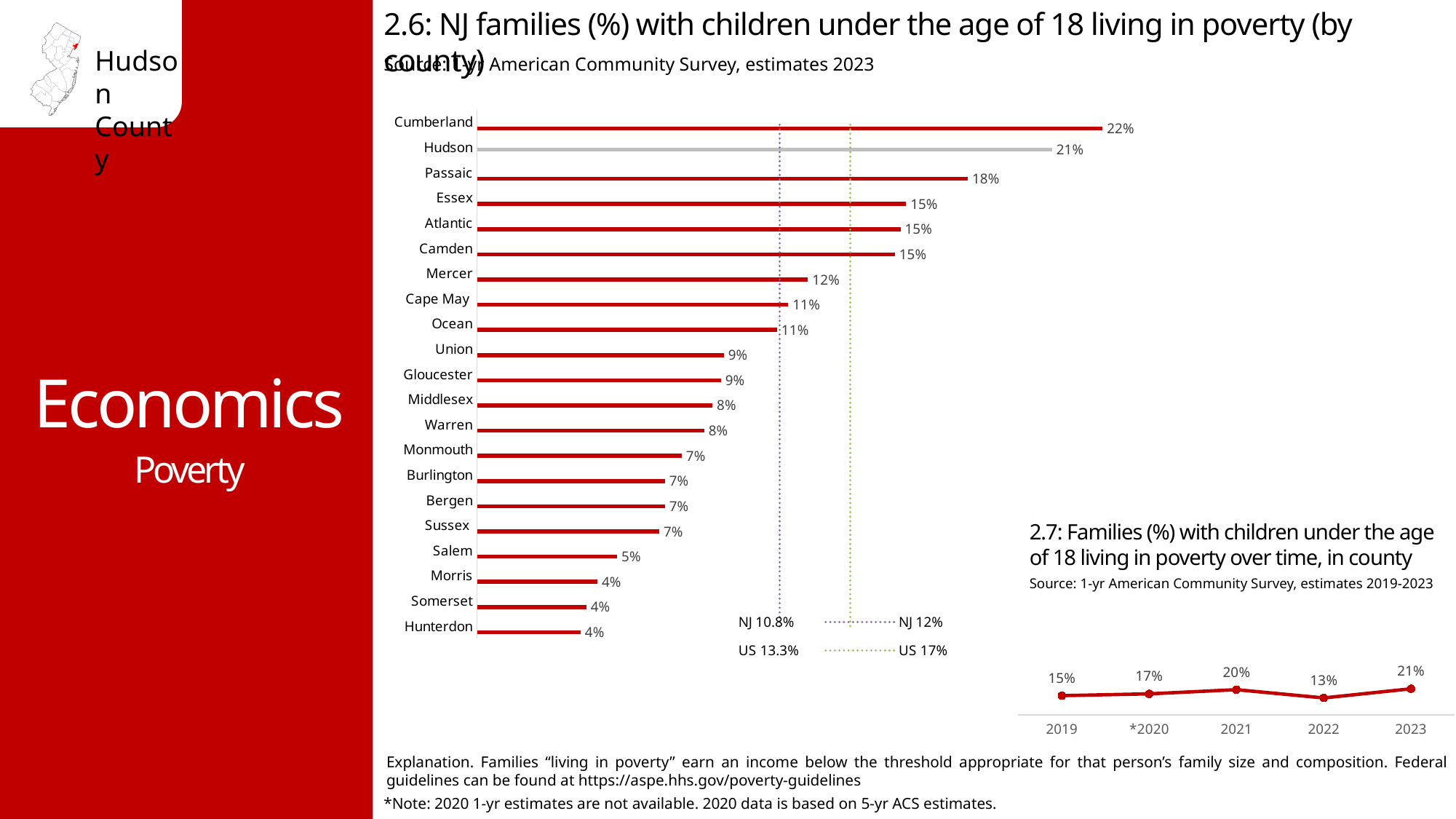
What kind of chart is chart 2.6? Bar chart In chart 2.6, which county has the highest percentage of families with children living in poverty? Cumberland In chart 2.6 (NJ families with children under 18 living in poverty by county), what is the value for Hudson? 21% In chart 2.7, which year has the lowest value? 2022 In chart 2.6, what is the difference between the values for Cumberland and Hudson? 1% In chart 2.6, what is the value for Salem? 5% In chart 2.7, what is the difference between the 2023 value and the 2022 value? 8% In chart 2.6, what is the value for Passaic? 18% In chart 2.6, which is larger, the value for Mercer or the value for Union? Mercer In chart 2.7 (families with children under 18 living in poverty over time, in county), what is the value for 2021? 20% In chart 2.6, how many counties are plotted? 21